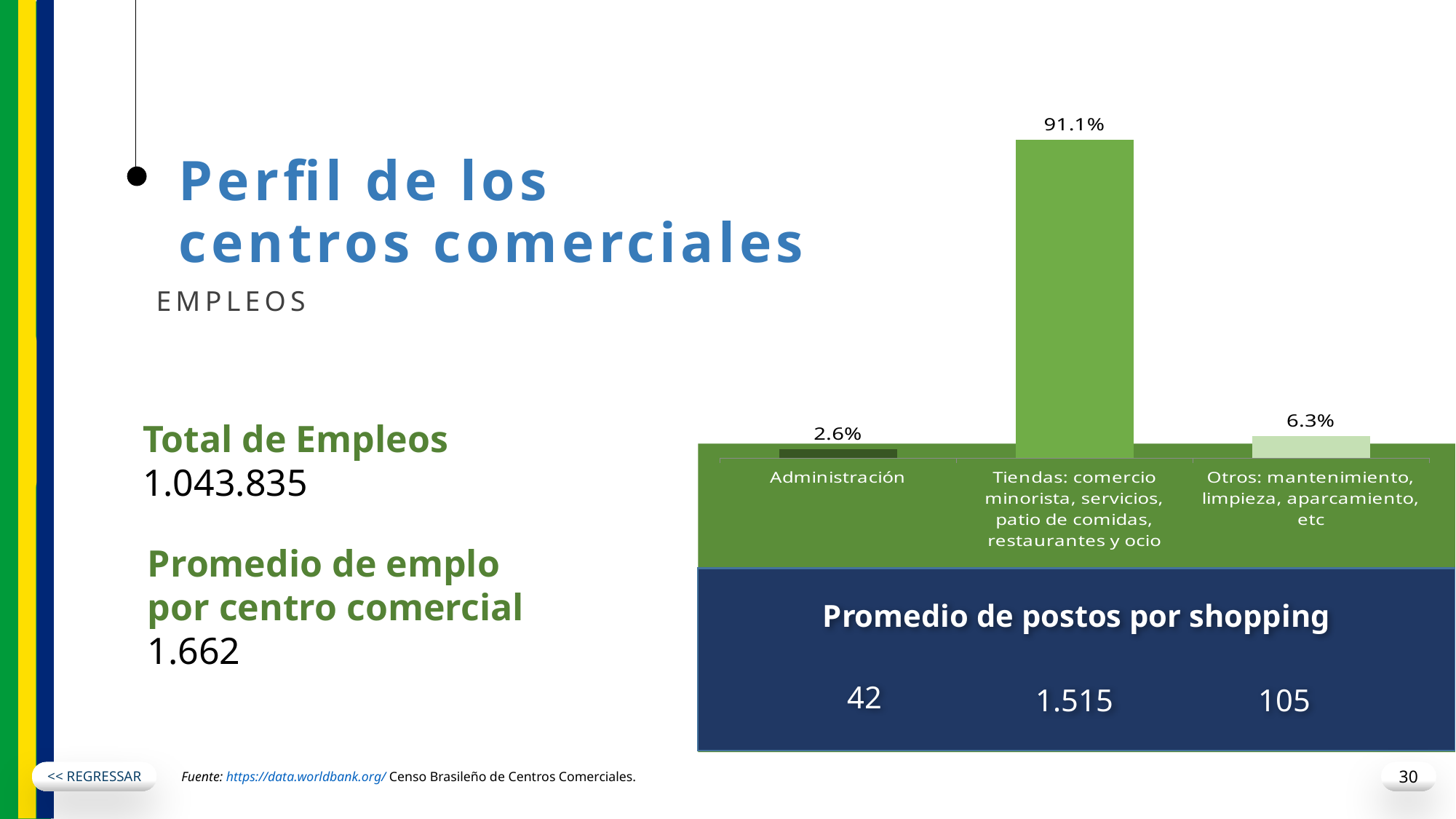
What percentage does the bar chart show for Otros: mantenimiento, limpieza, aparcamiento, etc? 6.3% What is the difference in percentage points between Otros and Administración in the bar chart? 3.7 How many categories are shown in the bar chart? 3 Which is larger in the bar chart, the value for Administración or the value for Otros? Otros What is the difference in percentage points between Tiendas and Otros in the bar chart? 84.8 What percentage does the bar chart show for Tiendas: comercio minorista, servicios, patio de comidas, restaurantes y ocio? 91.1% In the 'Promedio de postos por shopping' row below the chart, what value is shown under Tiendas? 1.515 Which category has the highest percentage in the bar chart? Tiendas: comercio minorista, servicios, patio de comidas, restaurantes y ocio What is the total of the three percentages shown in the bar chart? 100% What type of chart is shown on the slide? Bar chart What percentage does the bar chart show for Administración? 2.6% Which category has the lowest percentage in the bar chart? Administración